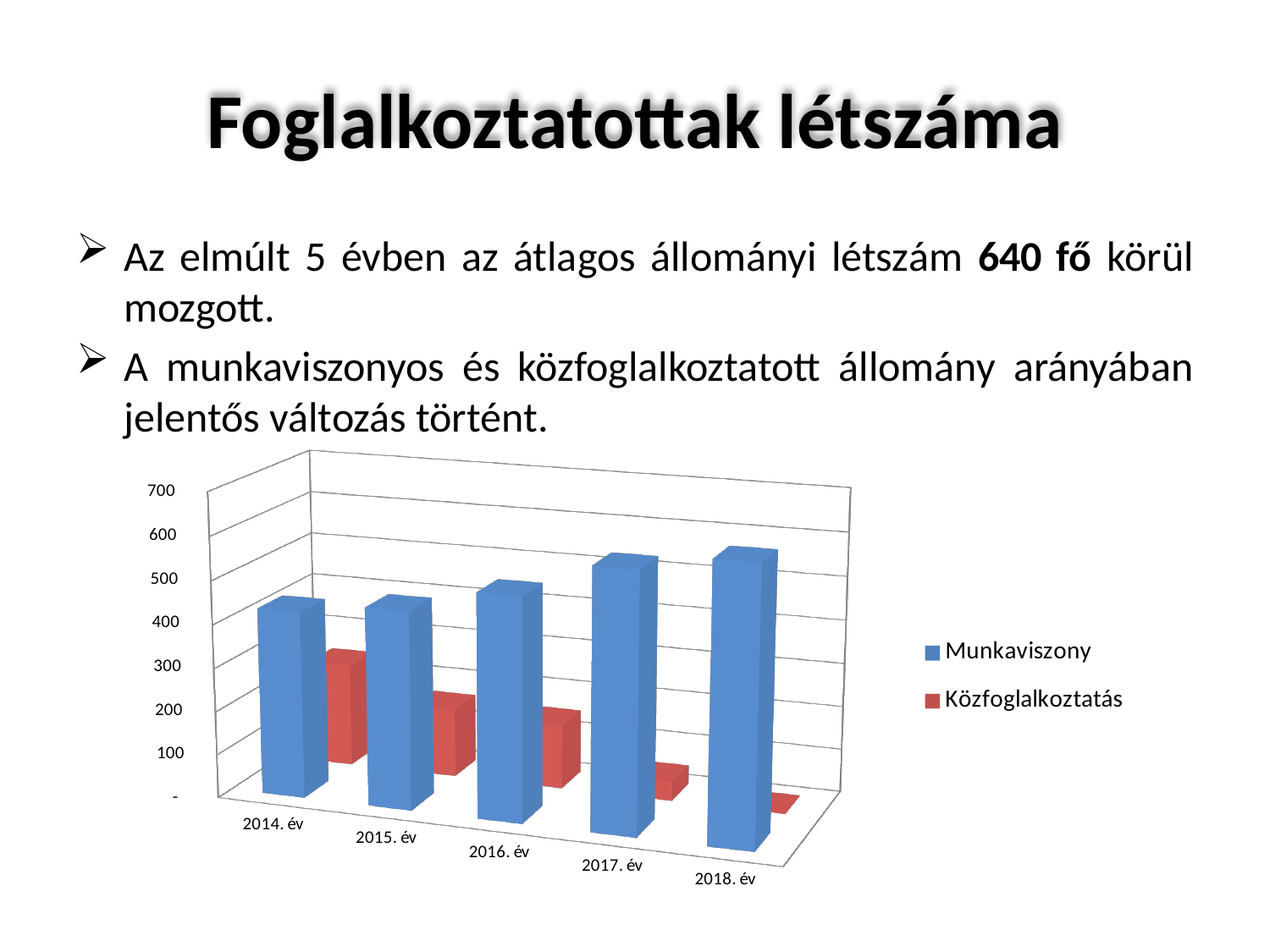
Does the Közfoglalkoztatás series rise or fall from 2014. év to 2018. év? fall How many series does the chart legend list? 2 In which year is the Közfoglalkoztatás value lowest? 2018. év Is the Közfoglalkoztatás value for 2018. év greater or less than 100? less What are the two legend entries of the chart? Munkaviszony, Közfoglalkoztatás Is the Munkaviszony value for 2014. év greater or less than 300? greater How many years are shown on the x axis of the chart? 5 In 2014. év, which is larger: Munkaviszony or Közfoglalkoztatás? Munkaviszony Does the Munkaviszony series rise or fall from 2014. év to 2018. év? rise Which series is shown in blue in the chart? Munkaviszony What kind of chart is shown on the slide? bar chart In which year is the Közfoglalkoztatás value highest? 2014. év